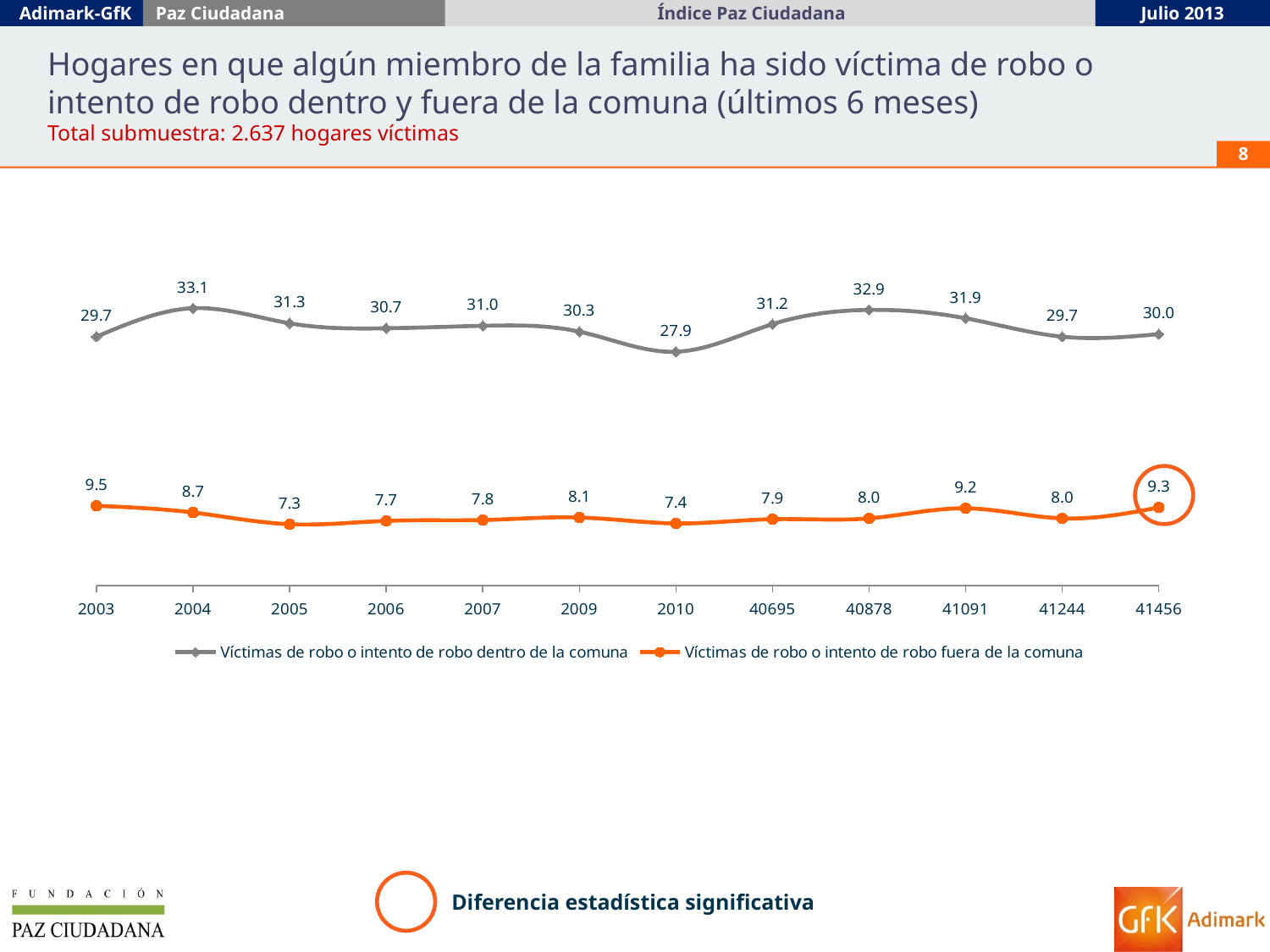
In which year does the 'dentro de la comuna' series reach its lowest value? 2010 What is the difference between the 'dentro de la comuna' values in 2004 and 2010? 5.2 What is the value for 'Víctimas de robo o intento de robo fuera de la comuna' in 2003? 9.5 How many data points does each series have? 12 What is the value for 'Víctimas de robo o intento de robo fuera de la comuna' at the last point on the x axis (41456)? 9.3 Which is larger for the 'fuera de la comuna' series: the value in 2003 or the value in 2005? 2003 In which year does the 'fuera de la comuna' series reach its lowest value? 2005 How many series does the legend list? 2 What is the value for 'Víctimas de robo o intento de robo dentro de la comuna' in 2004? 33.1 In which year does the 'dentro de la comuna' series reach its highest value? 2004 What is the value for 'Víctimas de robo o intento de robo dentro de la comuna' in 2010? 27.9 What kind of chart is shown on the slide? Line chart